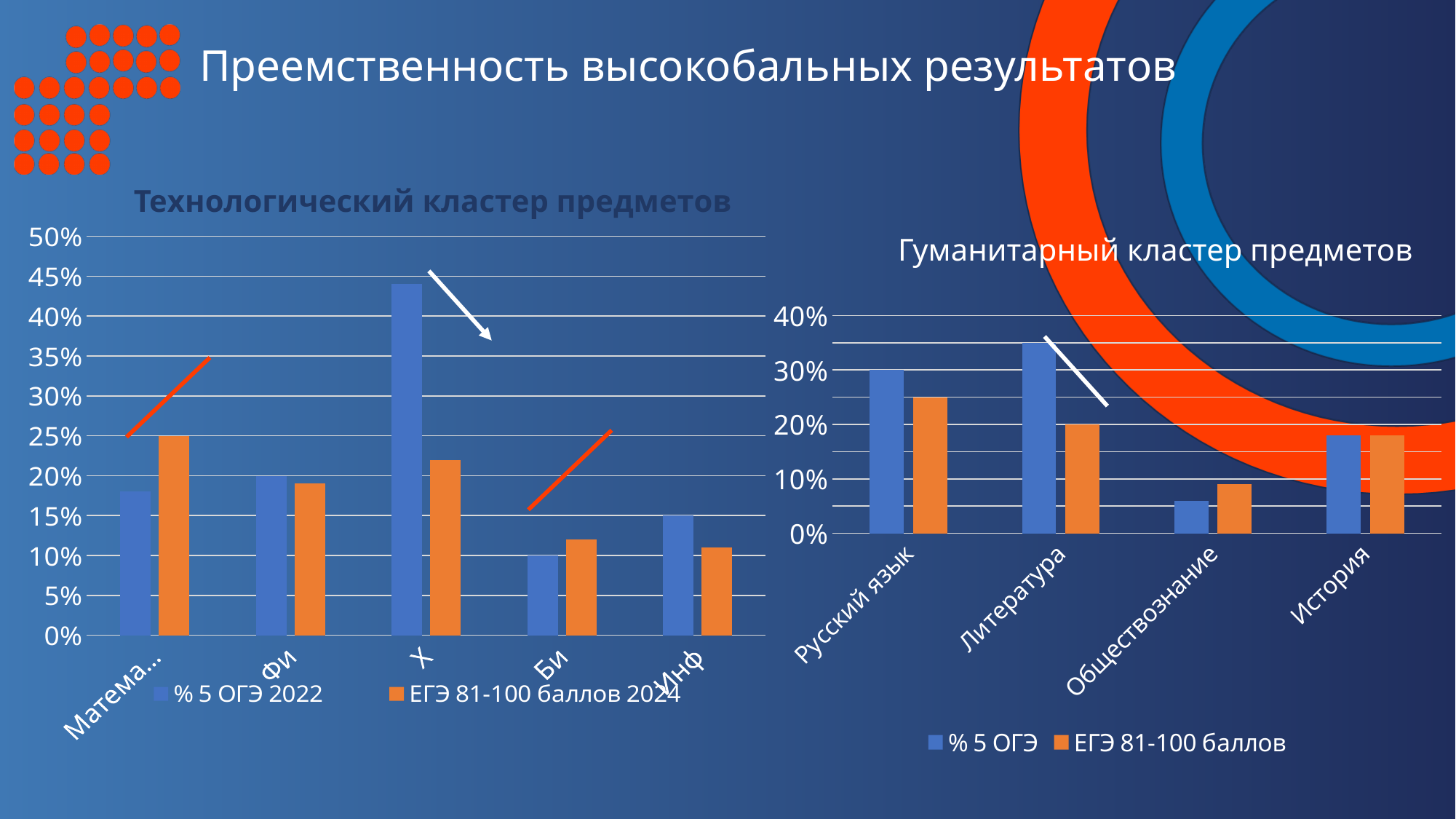
On the 'Гуманитарный кластер предметов' chart, which category has the highest '% 5 ОГЭ' value? Литература On the 'Технологический кластер предметов' chart, which category has the highest '% 5 ОГЭ 2022' value? Х On the 'Технологический кластер предметов' chart, which category has the lowest '% 5 ОГЭ 2022' value? Би On the 'Гуманитарный кластер предметов' chart, which category has the lowest 'ЕГЭ 81-100 баллов' value? Обществознание What is the title of the chart on the right side of the slide? Гуманитарный кластер предметов How many categories are shown on the 'Технологический кластер предметов' chart? 5 How many series does the legend of the 'Гуманитарный кластер предметов' chart list? 2 On the 'Технологический кластер предметов' chart, is the '% 5 ОГЭ 2022' value for Х greater or less than 40%? greater On the 'Гуманитарный кластер предметов' chart, what is the '% 5 ОГЭ' value for Русский язык? 30% On the 'Технологический кластер предметов' chart, which is larger for Матема...: '% 5 ОГЭ 2022' or 'ЕГЭ 81-100 баллов 2024'? ЕГЭ 81-100 баллов 2024 What kind of chart is the 'Технологический кластер предметов' chart? bar chart